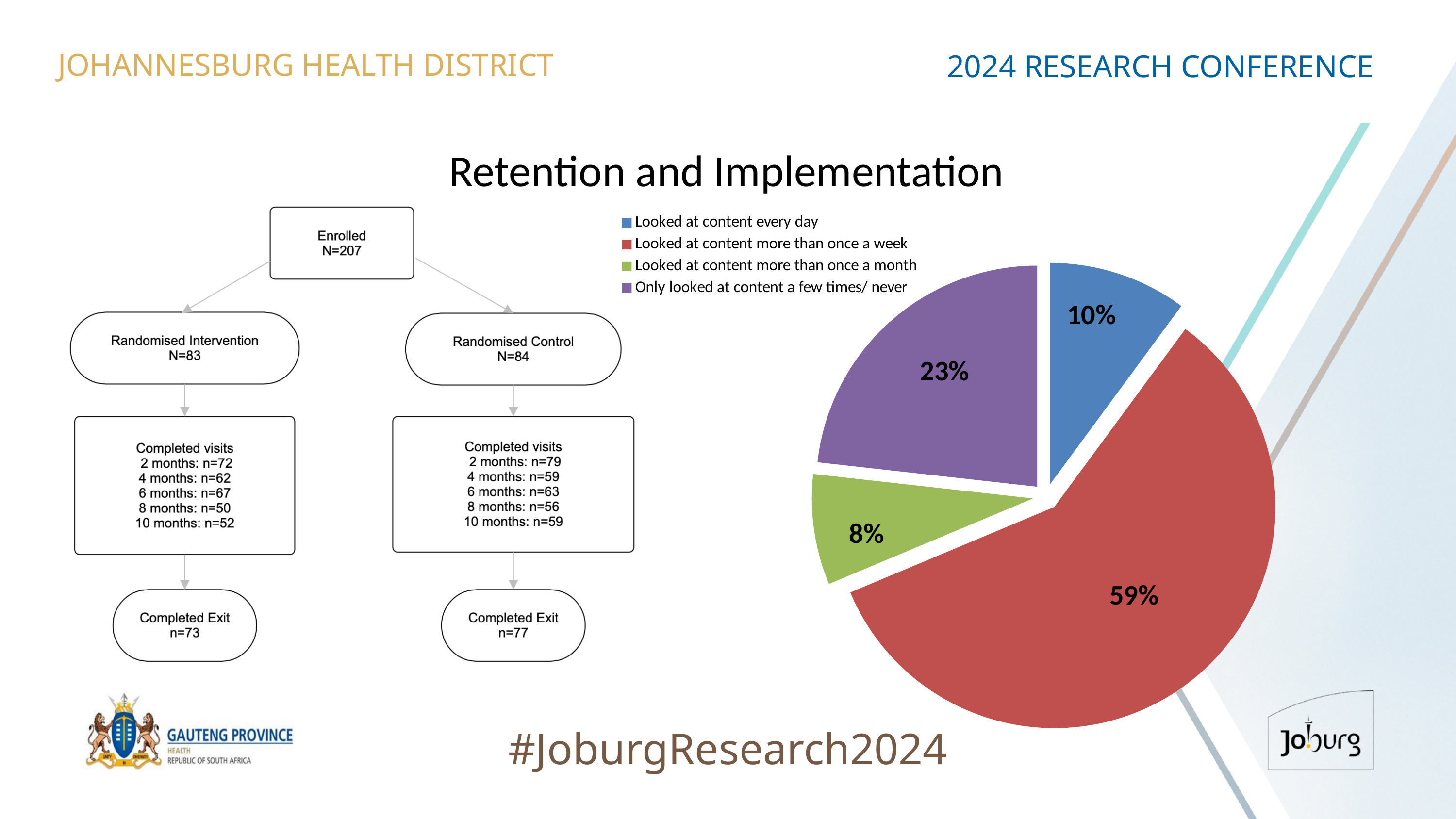
What colour is the slice for 'Only looked at content a few times/ never'? Purple What share of the pie chart is for 'Looked at content more than once a week'? 59% How many slices does the pie chart have? 4 What share of the pie chart is for 'Only looked at content a few times/ never'? 23% What kind of chart is shown on the right of the slide? Pie chart What is the difference in percentage points between 'Looked at content more than once a week' and 'Only looked at content a few times/ never'? 36 What share of the pie chart is for 'Looked at content more than once a month'? 8% Which is larger in the pie chart: 'Looked at content every day' or 'Looked at content more than once a month'? Looked at content every day Which category has the largest slice in the pie chart? Looked at content more than once a week How many entries does the pie chart legend list? 4 Which category has the smallest slice in the pie chart? Looked at content more than once a month What share of the pie chart is for 'Looked at content every day'? 10%